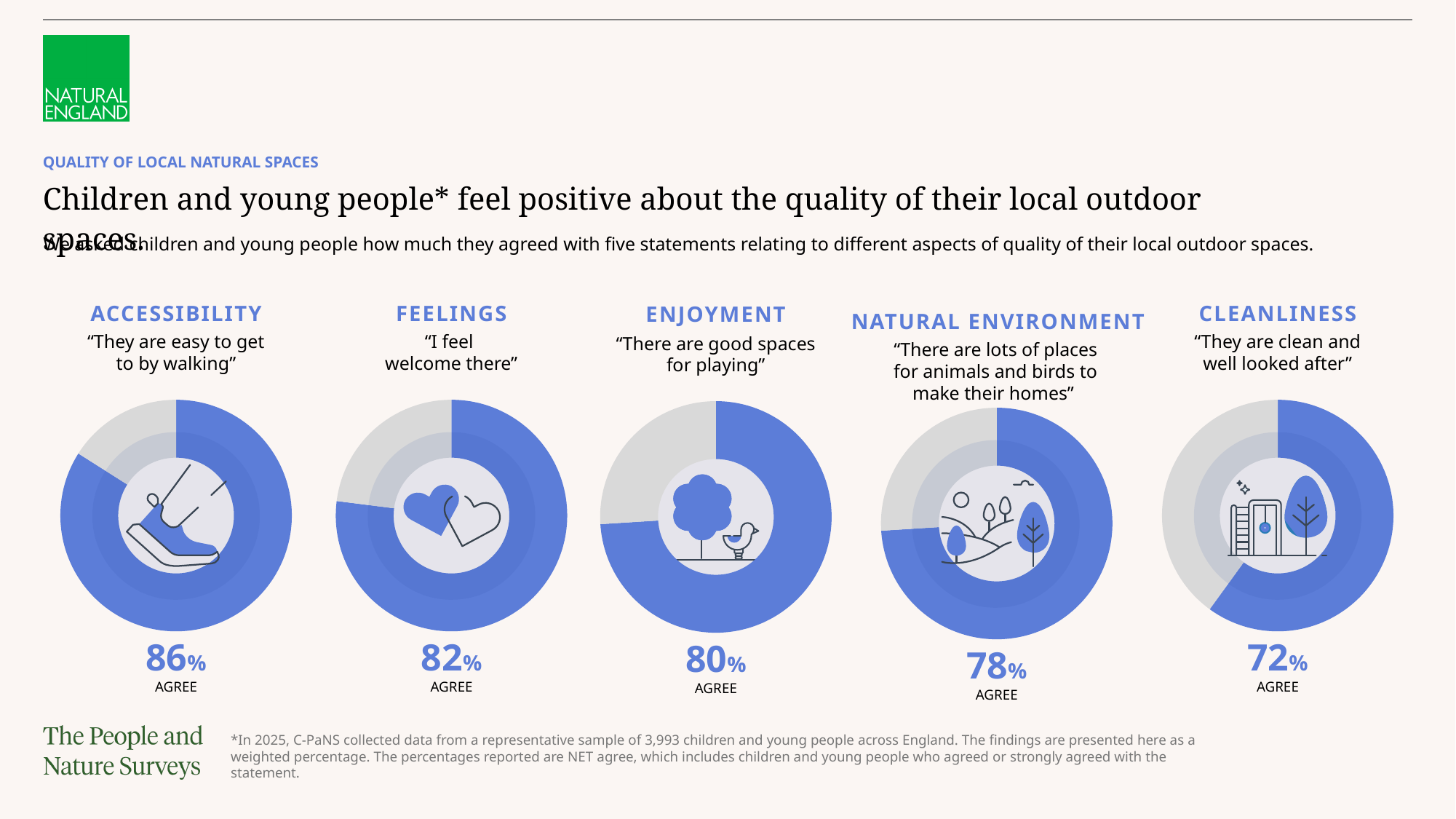
How many donut charts are shown on the slide? 5 Which has a higher agreement percentage, Feelings or Natural Environment? Feelings What percentage of children and young people agree with the Accessibility statement "They are easy to get to by walking"? 86% What kind of chart is used to show each agreement percentage on the slide? Donut chart Which of the five aspects of quality has the lowest percentage of agreement? Cleanliness What percentage agree with the Enjoyment statement "There are good spaces for playing"? 80% Which of the five aspects of quality has the highest percentage of agreement? Accessibility Reading the charts from left to right, do the agreement percentages rise or fall? Fall What percentage agree with the Natural Environment statement about places for animals and birds to make their homes? 78% What percentage agree with the Cleanliness statement "They are clean and well looked after"? 72% What is the difference in percentage points between the Accessibility agreement and the Cleanliness agreement? 14 What percentage agree with the Feelings statement "I feel welcome there"? 82%